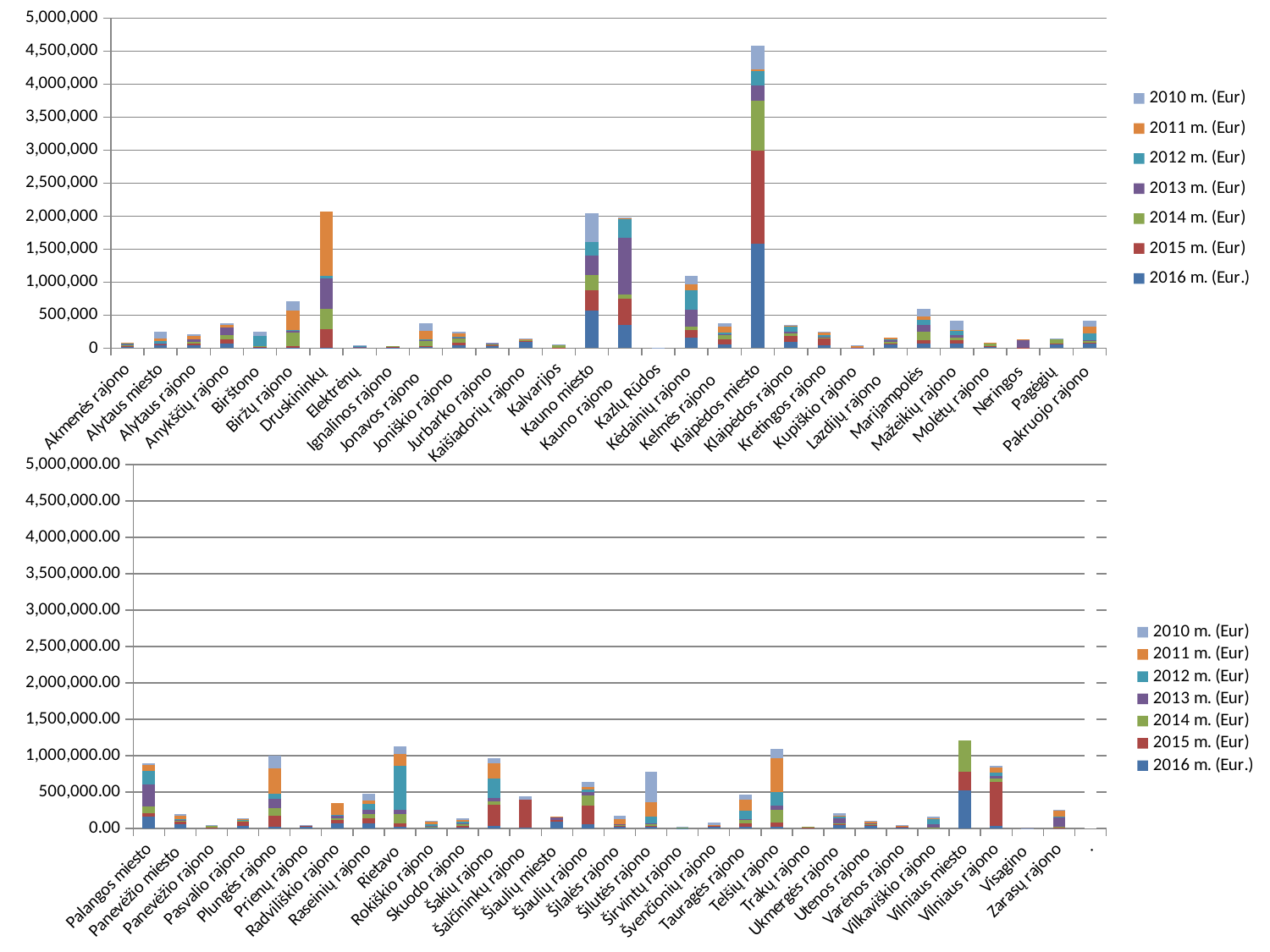
In the top chart, which category has the tallest stacked bar? Klaipėdos miesto In the top chart, is the total value for Druskininkų greater or less than 1,500,000? greater In the bottom chart, is the total value for Vilniaus miesto greater or less than 1,000,000.00? greater In the top chart, is the total value for Klaipėdos miesto greater or less than 4,000,000? greater How many series does the legend of the top chart list? 7 How many categories are shown on the x axis of the top chart? 30 What kind of chart is the top chart on the slide? bar chart How many series does the legend of the bottom chart list? 7 In the top chart, which has the larger total: Klaipėdos miesto or Kauno miesto? Klaipėdos miesto In the bottom chart, which has the larger total: Rietavo or Palangos miesto? Rietavo In the bottom chart, which category has the tallest stacked bar? Vilniaus miesto